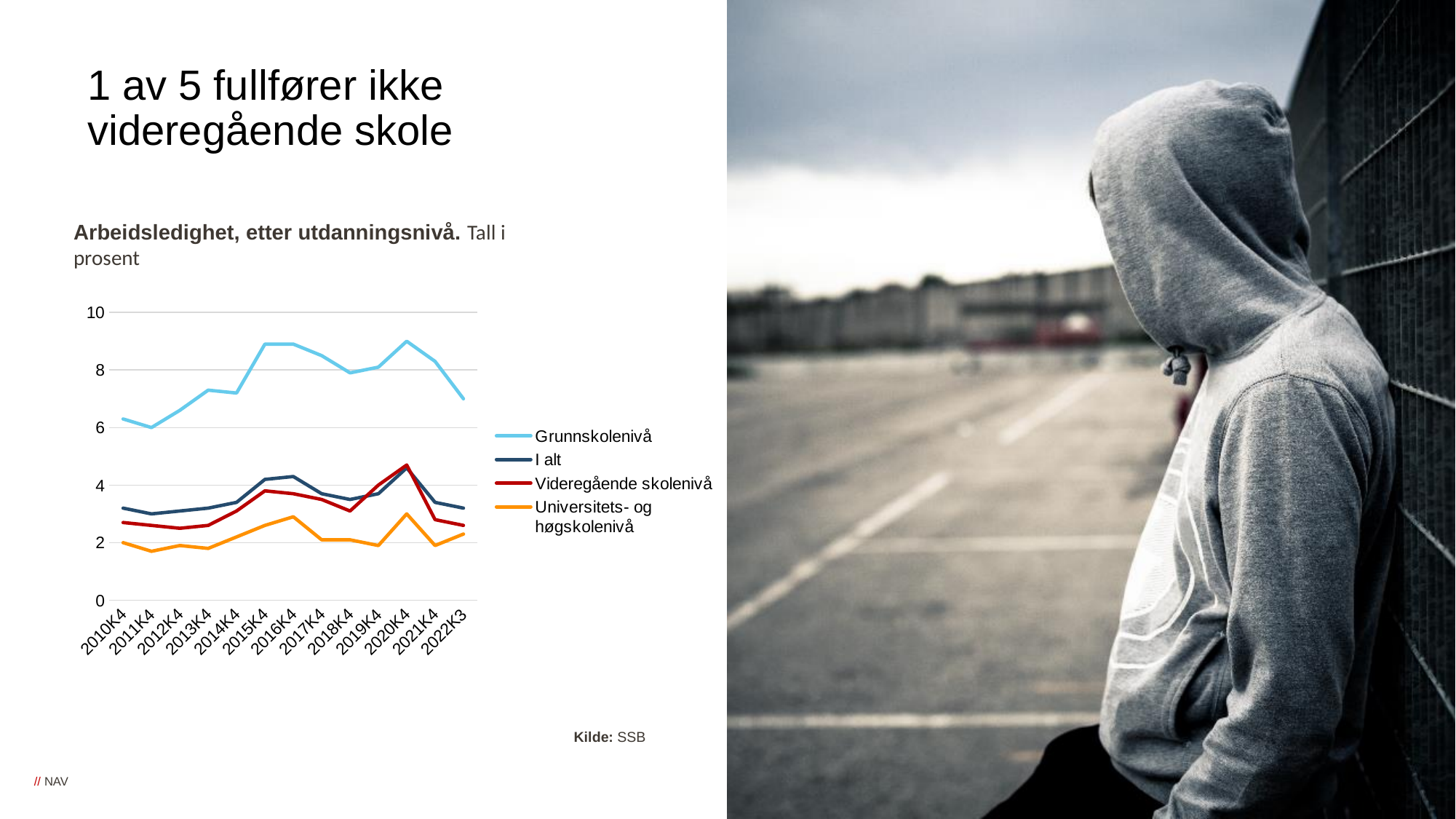
At 2016K4, which is larger: I alt or Videregående skolenivå? I alt At which time point is the Grunnskolenivå series at its lowest? 2011K4 What source is cited for the chart? SSB How many time points are shown on the x axis of the chart? 13 What kind of chart is shown on the slide? line chart Is the value for Grunnskolenivå at 2020K4 greater or less than 8? greater How many series does the chart legend list? 4 Which series has the lowest values across the whole chart? Universitets- og høgskolenivå Is the value for Videregående skolenivå at 2020K4 greater or less than 4? greater Does the Grunnskolenivå series rise or fall from 2020K4 to 2022K3? fall Is the value for Universitets- og høgskolenivå at 2011K4 greater or less than 2? less Which series has the highest values across the whole chart? Grunnskolenivå